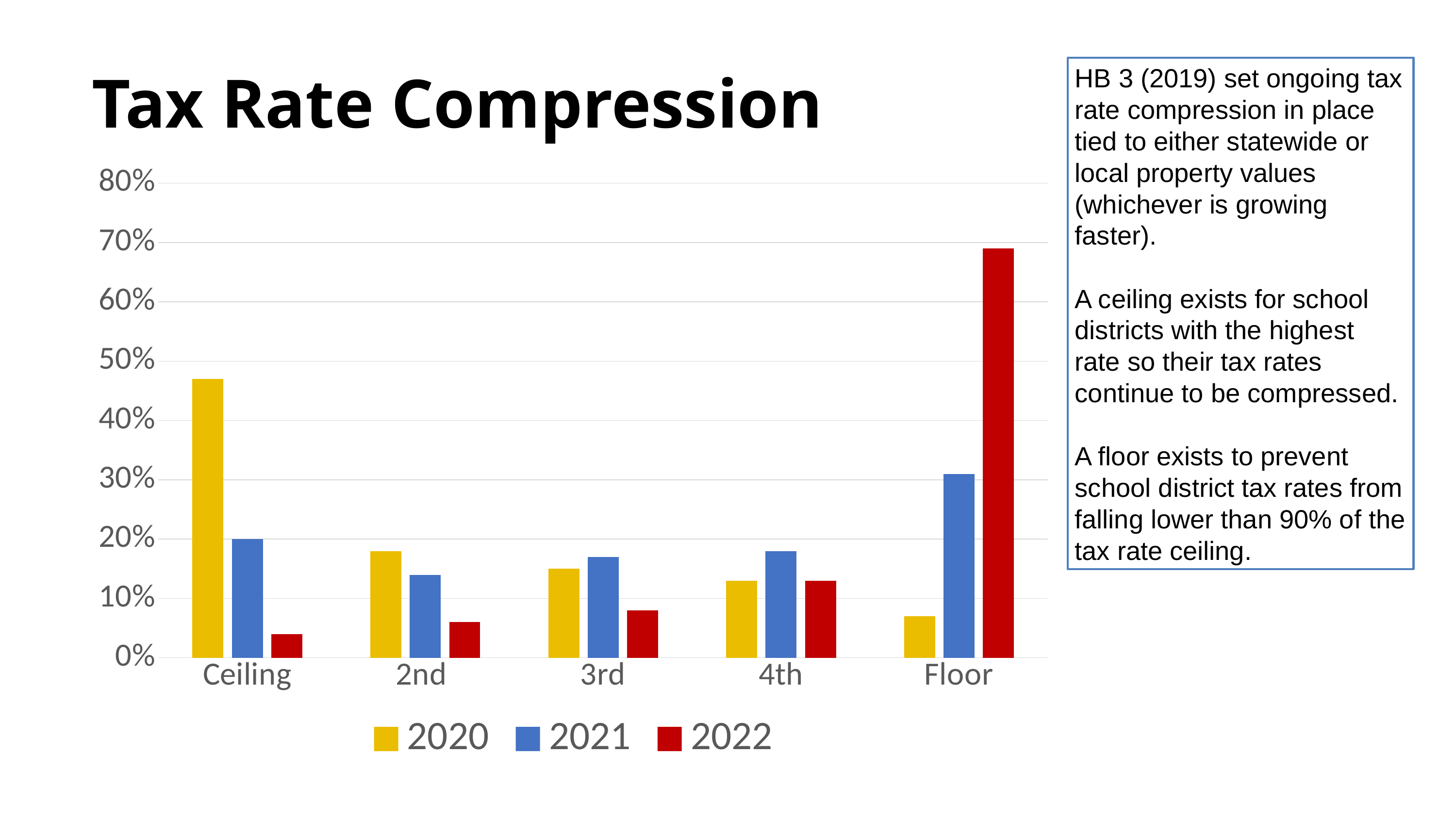
Is the 2022 value for Ceiling greater or less than 10%? less What is the title of the chart? Tax Rate Compression Which category has the lowest 2020 value? Floor Which category has the highest 2020 value? Ceiling How many series does the legend list? 3 Is the 2020 value for Ceiling greater or less than 40%? greater Which category has the highest 2022 value? Floor What kind of chart is shown on the slide? Bar chart Which is larger: the 2021 value for Ceiling or the 2021 value for Floor? Floor Which category has the lowest 2022 value? Ceiling Is the 2022 value for Floor greater or less than 60%? greater How many categories are shown on the x axis? 5